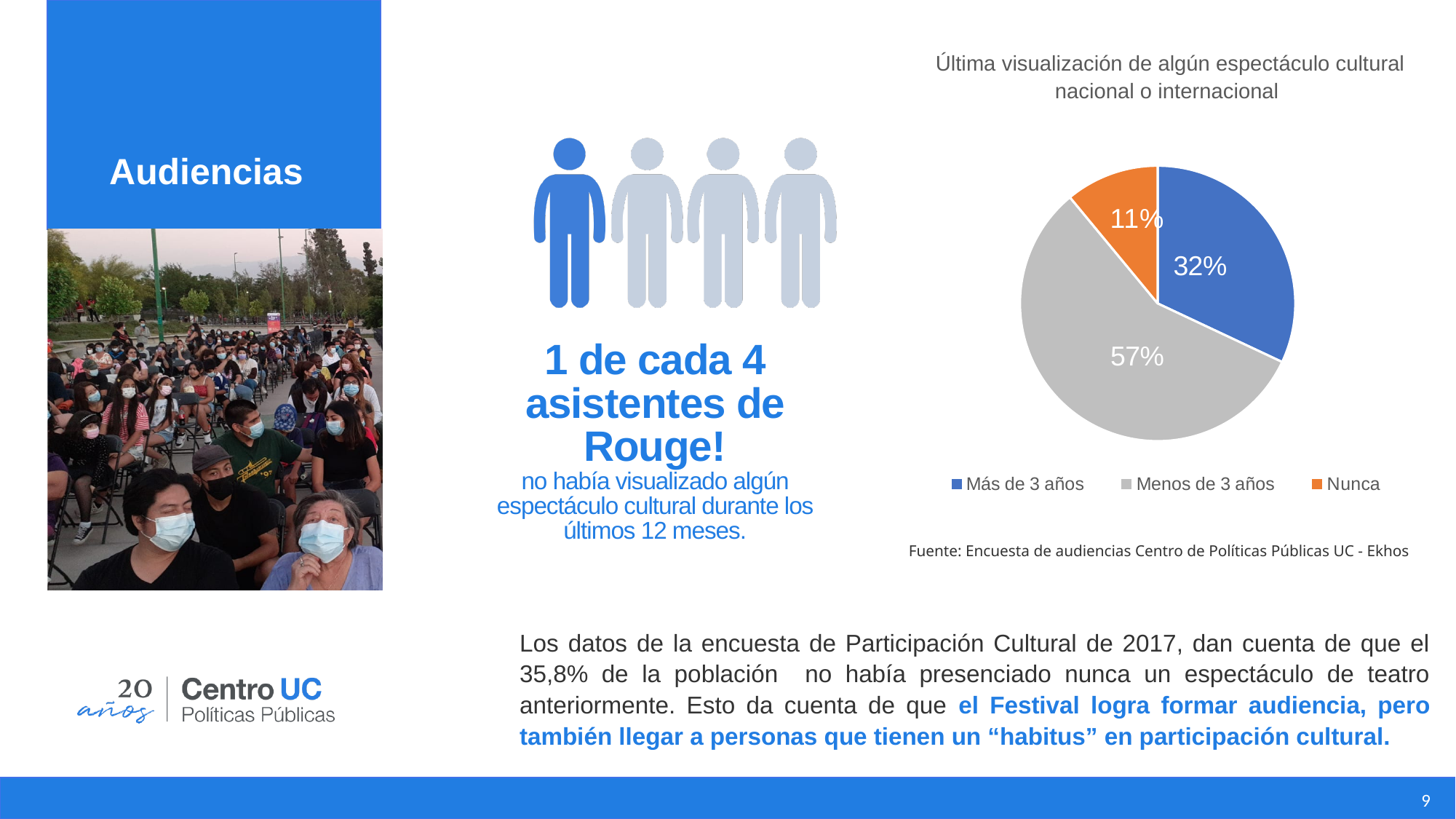
What percentage of the pie chart corresponds to 'Más de 3 años'? 32% What is the title of the pie chart? Última visualización de algún espectáculo cultural nacional o internacional What percentage of the pie chart corresponds to 'Nunca'? 11% What is the difference in percentage points between 'Menos de 3 años' and 'Más de 3 años'? 25 How many categories does the pie chart have? 3 What type of chart is shown on the slide? pie chart Which is larger in the pie chart, 'Más de 3 años' or 'Nunca'? Más de 3 años What is the difference in percentage points between 'Más de 3 años' and 'Nunca'? 21 Which category has the smallest share of the pie chart? Nunca Which category has the largest share of the pie chart? Menos de 3 años What colour is the 'Nunca' slice in the pie chart? orange What percentage of the pie chart corresponds to 'Menos de 3 años'? 57%